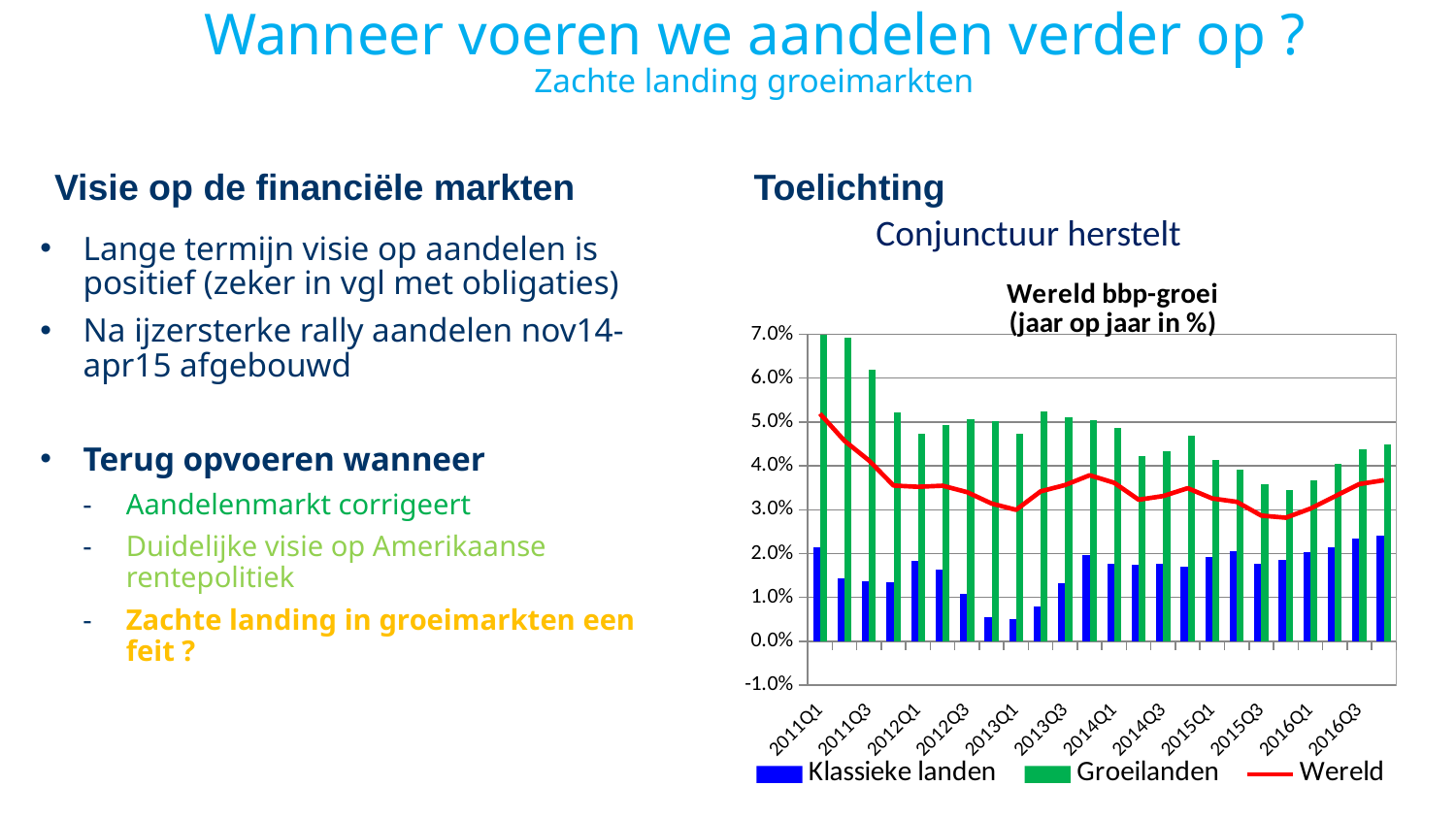
What is the title of the chart on the slide? Wereld bbp-groei (jaar op jaar in %) Is the Wereld value for 2011Q1 greater or less than 4.0%? greater How many series does the chart legend list? 3 Is the Klassieke landen value for 2011Q1 greater or less than 3.0%? less Is the Groeilanden value for 2016Q3 greater or less than 4.0%? greater In which quarter is the Groeilanden value highest? 2011Q1 Which series is drawn as a red line in the chart? Wereld Which is larger in 2011Q1, the Groeilanden value or the Klassieke landen value? Groeilanden Does the Wereld line overall rise or fall from 2011Q1 to 2016Q3? fall What kind of chart is shown on the slide? A combined bar and line chart